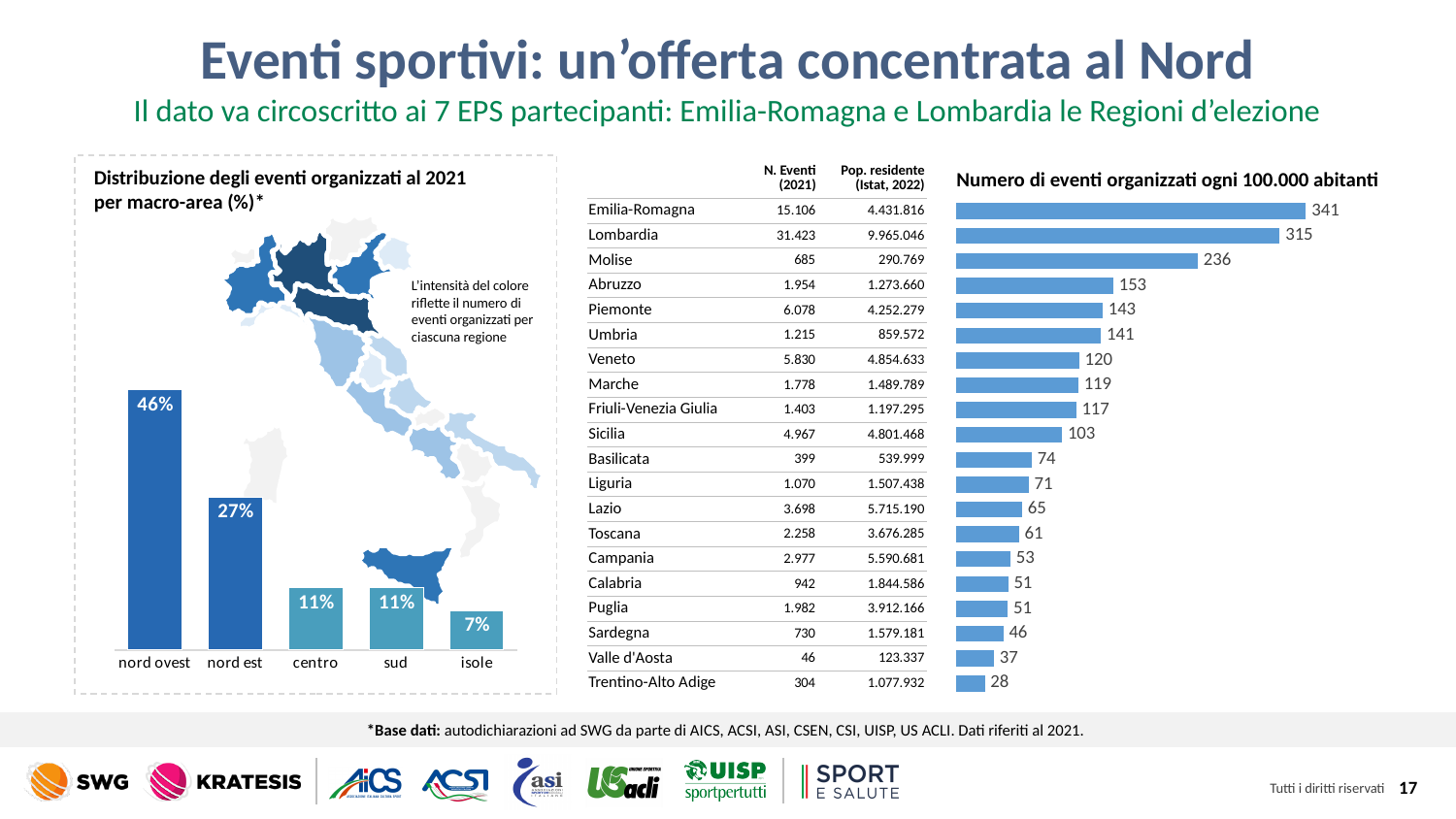
What kind of chart is 'Distribuzione degli eventi organizzati al 2021 per macro-area (%)'? bar chart In the chart 'Distribuzione degli eventi organizzati al 2021 per macro-area (%)', what is the value for nord ovest? 46% In the chart 'Numero di eventi organizzati ogni 100.000 abitanti', which region has the highest value? Emilia-Romagna In the chart 'Numero di eventi organizzati ogni 100.000 abitanti', how many regions are shown? 20 In the chart 'Numero di eventi organizzati ogni 100.000 abitanti', which region has the lowest value? Trentino-Alto Adige In the chart 'Distribuzione degli eventi organizzati al 2021 per macro-area (%)', which macro-area has the lowest share? isole In the chart 'Numero di eventi organizzati ogni 100.000 abitanti', what is the value for Molise? 236 In the chart 'Distribuzione degli eventi organizzati al 2021 per macro-area (%)', what is the difference between nord ovest and nord est? 19% In the chart 'Distribuzione degli eventi organizzati al 2021 per macro-area (%)', how many macro-areas are shown? 5 In the chart 'Numero di eventi organizzati ogni 100.000 abitanti', which is larger, the value for Sicilia or the value for Basilicata? Sicilia In the chart 'Numero di eventi organizzati ogni 100.000 abitanti', what is the value for Valle d'Aosta? 37 In the chart 'Numero di eventi organizzati ogni 100.000 abitanti', what is the difference between Emilia-Romagna and Lombardia? 26